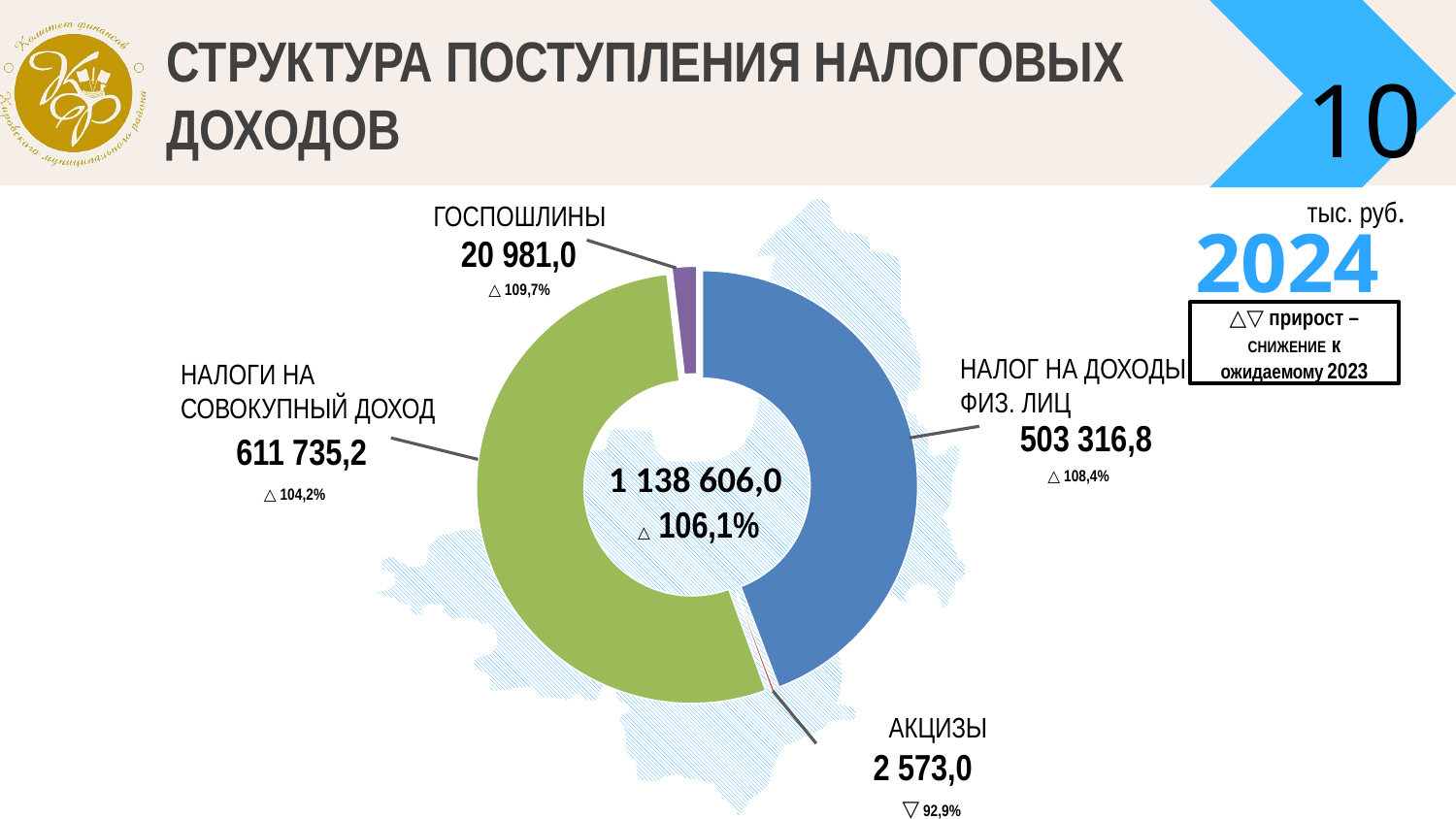
What is the value for ГОСПОШЛИНЫ? 20 981,0 What is the value for АКЦИЗЫ? 2 573,0 Which category has the smallest value? АКЦИЗЫ What type of chart is shown on the slide? Donut (pie) chart What total value is shown in the centre of the donut chart? 1 138 606,0 What growth percentage is shown next to АКЦИЗЫ? 92,9% What is the value for НАЛОГ НА ДОХОДЫ ФИЗ. ЛИЦ? 503 316,8 Which category has the largest value? НАЛОГИ НА СОВОКУПНЫЙ ДОХОД Which is larger: ГОСПОШЛИНЫ or АКЦИЗЫ? ГОСПОШЛИНЫ How many categories are shown in the donut chart? 4 What is the difference between НАЛОГИ НА СОВОКУПНЫЙ ДОХОД and НАЛОГ НА ДОХОДЫ ФИЗ. ЛИЦ? 108 418,4 What is the value for НАЛОГИ НА СОВОКУПНЫЙ ДОХОД? 611 735,2